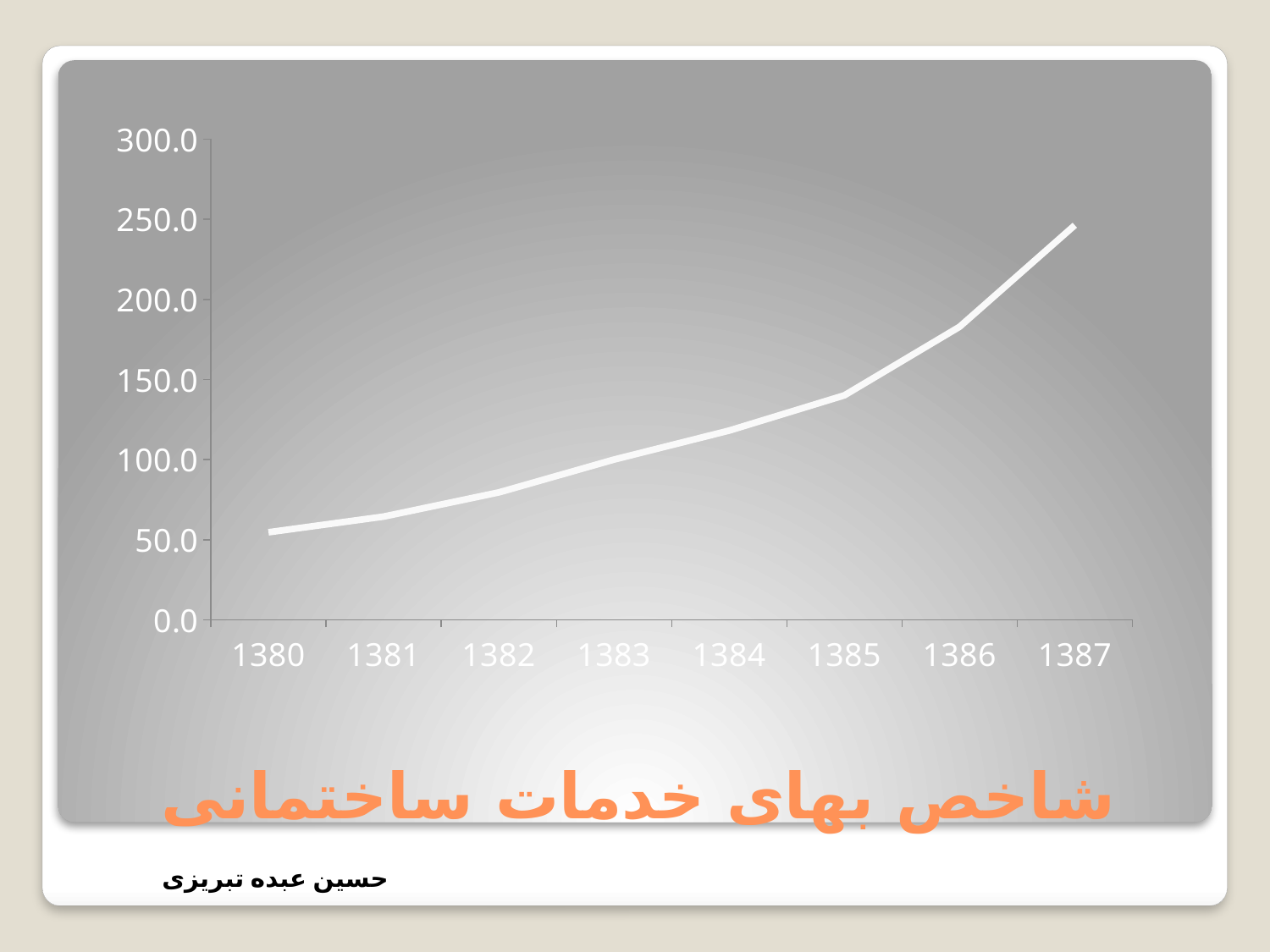
What kind of chart is shown on the slide? line chart Is the value for 1382 greater or less than 100.0? less Is the value for 1387 greater or less than 200.0? greater Which year has the highest value? 1387 Which is larger, the value for 1385 or the value for 1383? 1385 What is the first year shown on the x axis? 1380 Do the values rise or fall from 1380 to 1387? rise Which year has the lowest value? 1380 What is the highest tick value shown on the y axis? 300.0 Is the value for 1380 greater or less than 100.0? less How many years are plotted along the x axis? 8